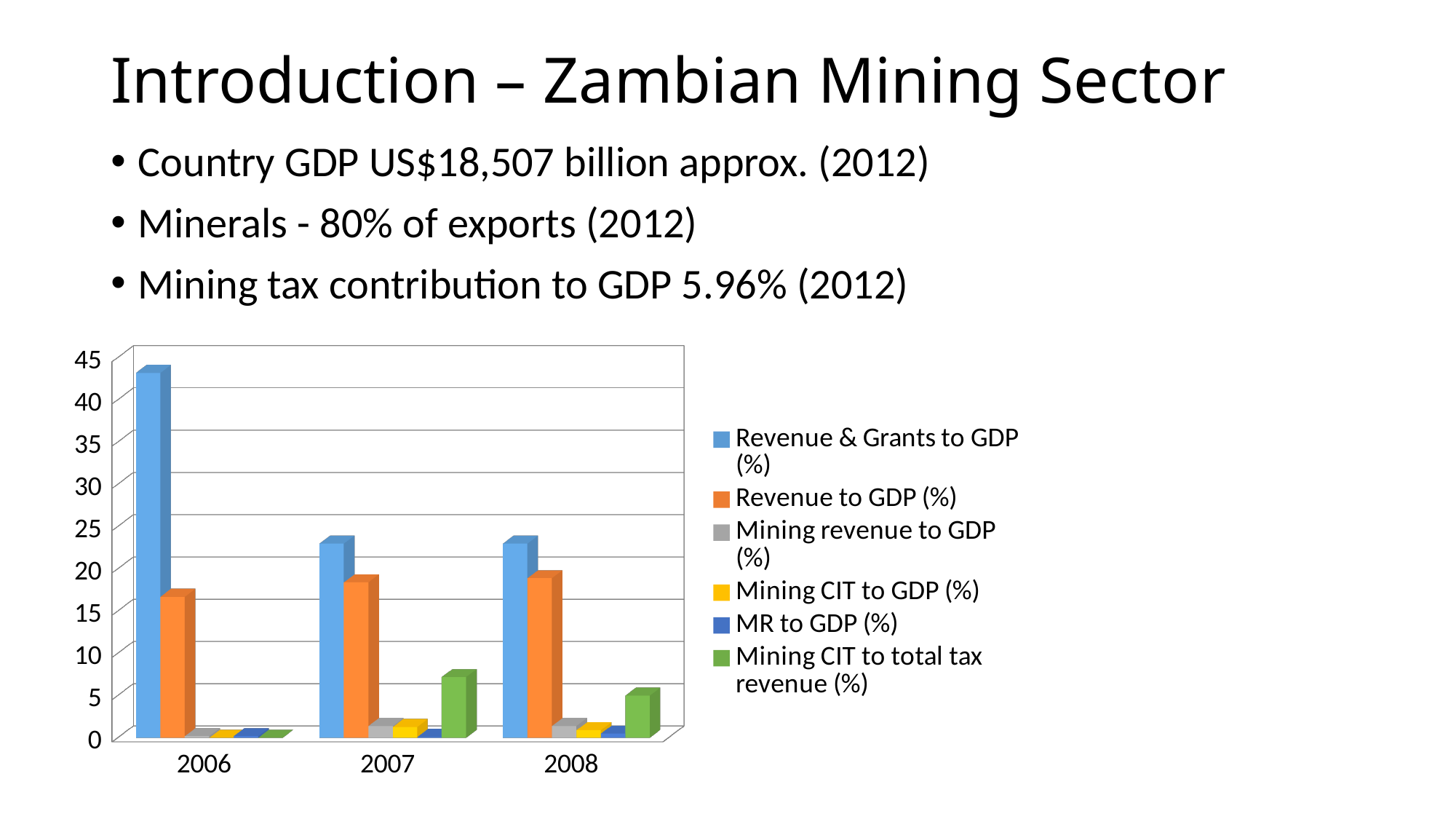
Does Revenue & Grants to GDP (%) rise or fall from 2006 to 2007? fall Is the value for Revenue & Grants to GDP (%) in 2006 greater or less than 40? greater Is the value for Revenue & Grants to GDP (%) in 2007 greater or less than 25? less What kind of chart is shown on the slide? bar chart Which colour represents Mining CIT to total tax revenue (%) in the chart legend? green How many series does the chart legend list? 6 Is the value for Mining CIT to total tax revenue (%) in 2007 greater or less than 5? greater In which year is Revenue & Grants to GDP (%) highest? 2006 How many years are shown on the x axis of the chart? 3 In 2006, which is larger: Revenue & Grants to GDP (%) or Revenue to GDP (%)? Revenue & Grants to GDP (%)